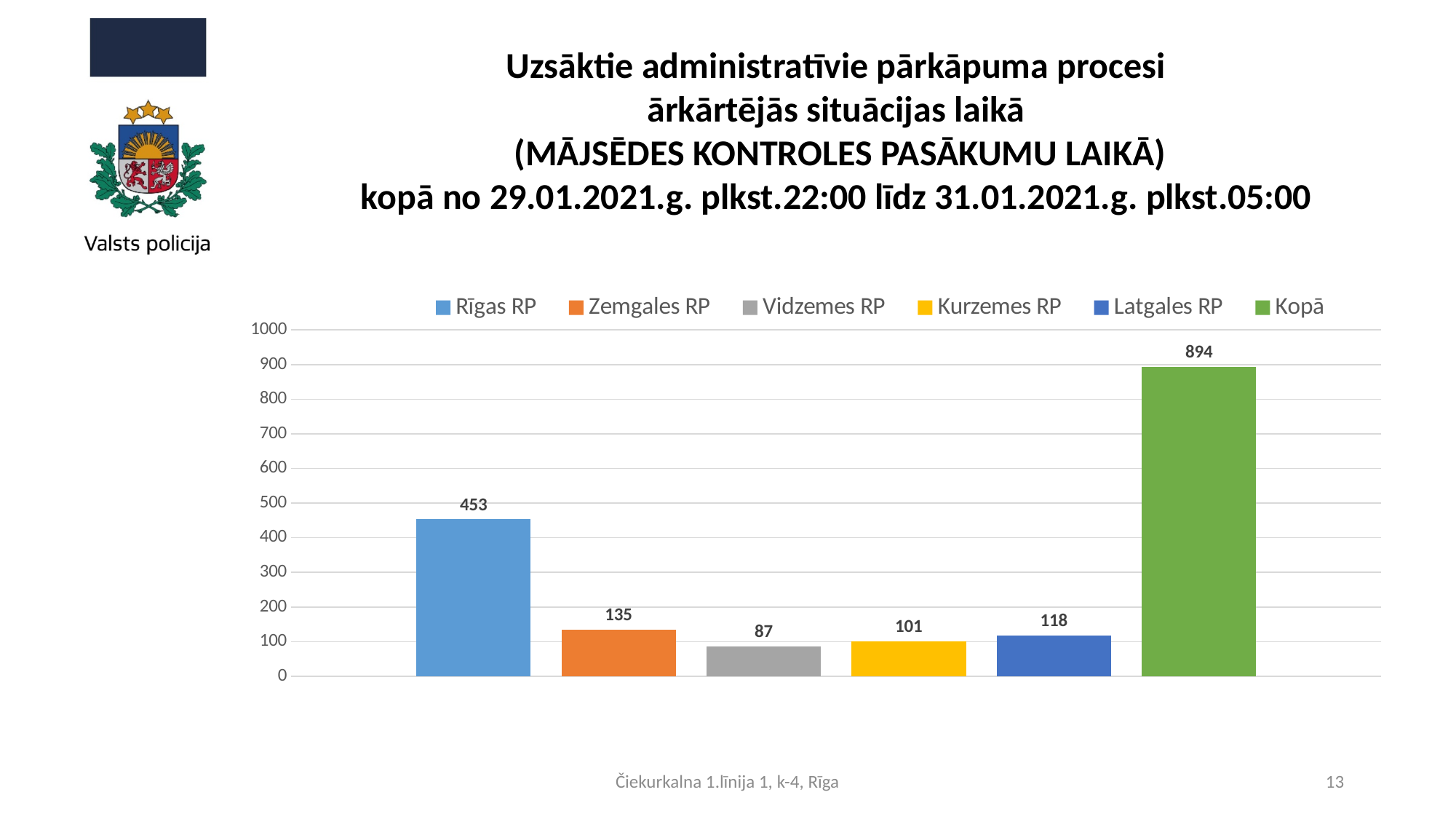
What is the value for Latgales RP? 118 Which regional police (RP) has the highest value, excluding Kopā? Rīgas RP Which is larger, the value for Latgales RP or Kurzemes RP? Latgales RP What is the difference between the values for Rīgas RP and Zemgales RP? 318 What is the value for Rīgas RP? 453 What kind of chart is shown on the slide? Bar chart What is the value for Vidzemes RP? 87 What is the value for Kurzemes RP? 101 Which regional police (RP) has the lowest value? Vidzemes RP What is the value for Kopā? 894 What is the value for Zemgales RP? 135 How many series does the legend list? 6